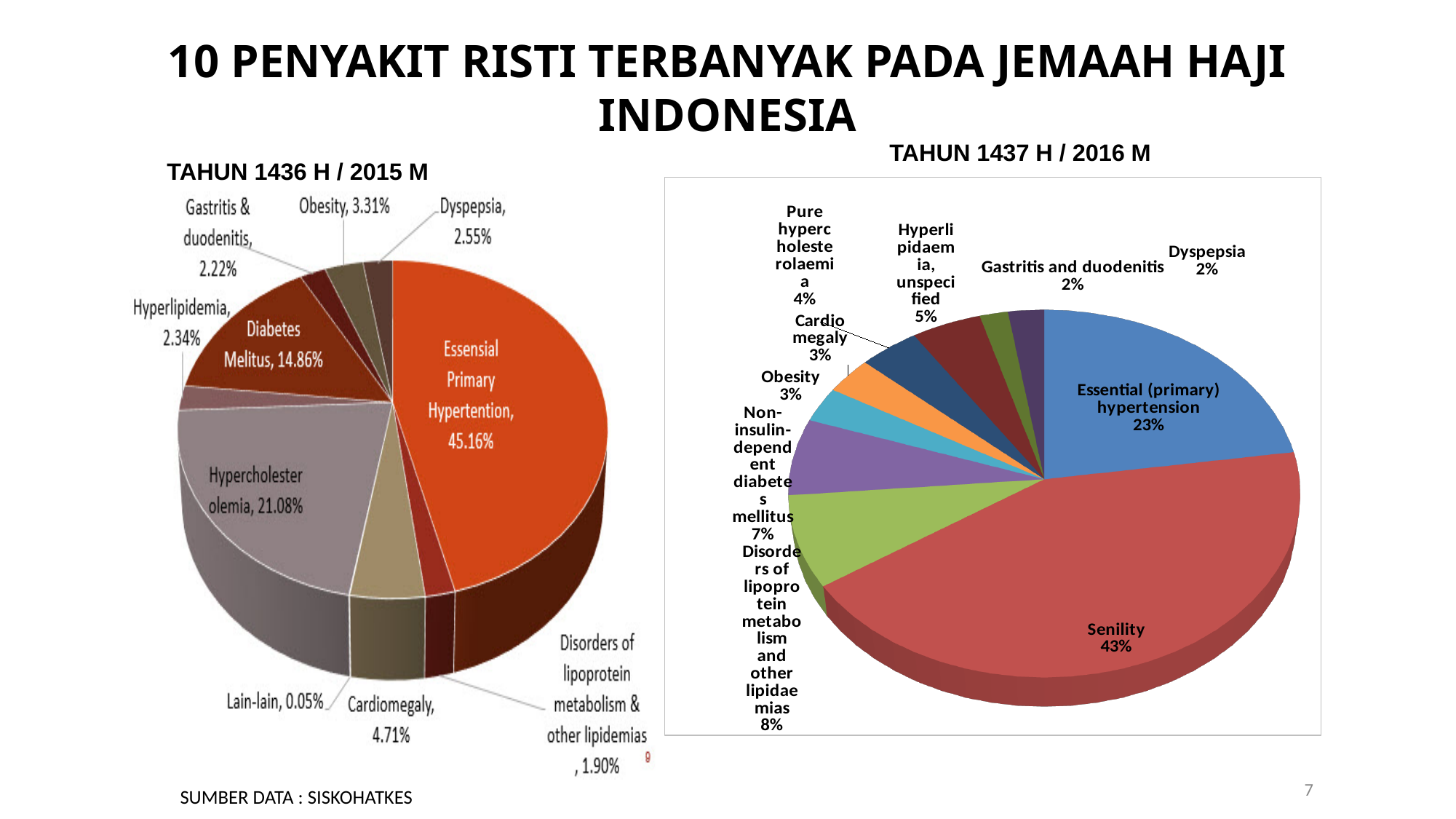
In the TAHUN 1436 H / 2015 M chart, what is the share for Hypercholesterolemia? 21.08% In the TAHUN 1437 H / 2016 M chart, what is the share for Essential (primary) hypertension? 23% In the TAHUN 1436 H / 2015 M chart, what is the difference between Diabetes Melitus and Cardiomegaly? 10.15% In the TAHUN 1437 H / 2016 M chart, which category has the largest share? Senility What kind of chart is used for TAHUN 1436 H / 2015 M? Pie chart In the TAHUN 1436 H / 2015 M chart, what is the share for Essensial Primary Hypertention? 45.16% In the TAHUN 1436 H / 2015 M chart, which category has the smallest share? Lain-lain What is the data source stated at the bottom of the slide? SISKOHATKES In the TAHUN 1437 H / 2016 M chart, what is the difference between Senility and Essential (primary) hypertension? 20% In the TAHUN 1437 H / 2016 M chart, what is the share for Non-insulin-dependent diabetes mellitus? 7% In the TAHUN 1436 H / 2015 M chart, which is larger, Obesity or Dyspepsia? Obesity How many categories are shown in the TAHUN 1436 H / 2015 M chart? 10